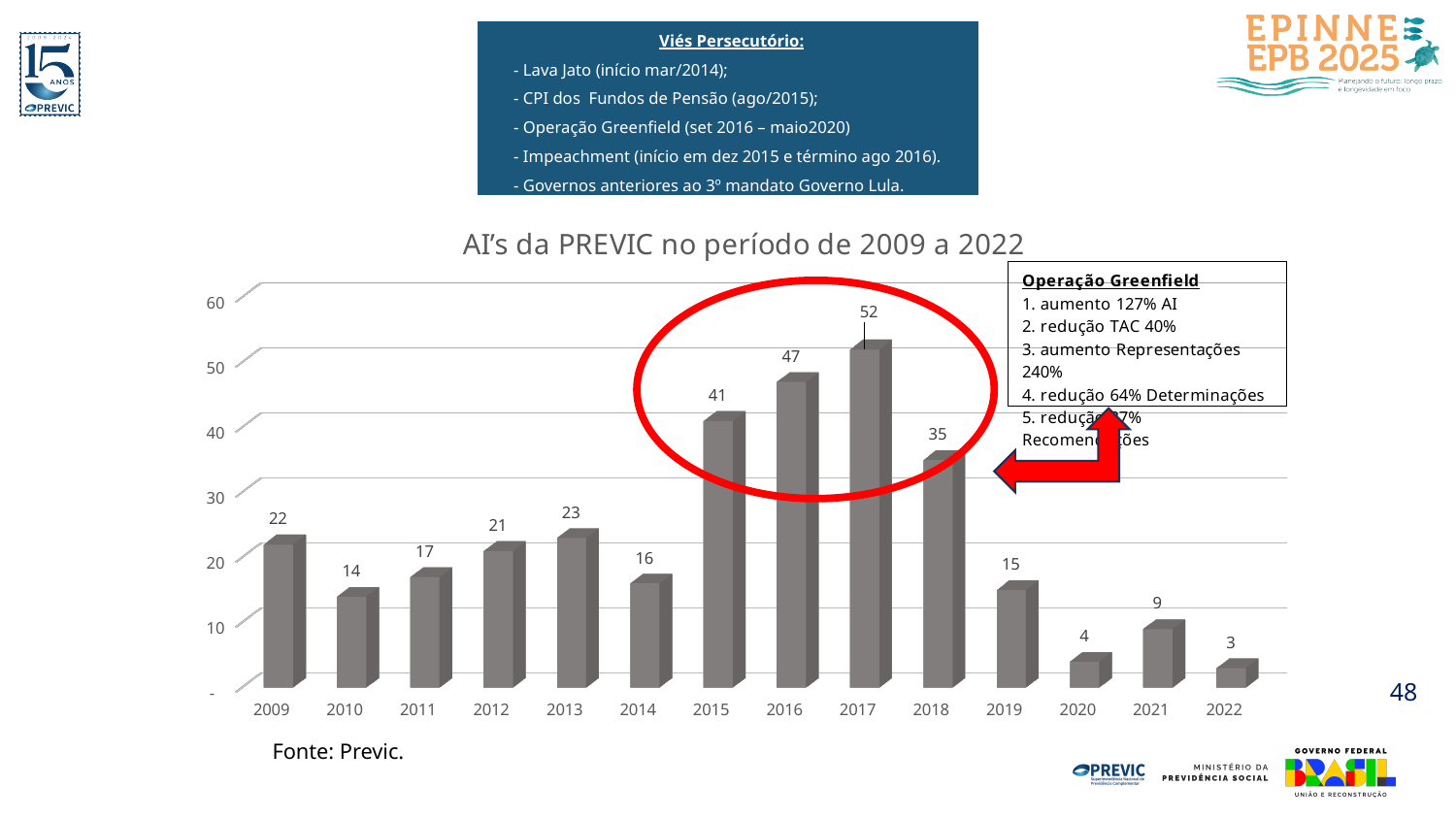
Is the value for 2016 greater or less than 40? greater What is the difference between the values for 2017 and 2016? 5 What is the title of the chart? AI’s da PREVIC no período de 2009 a 2022 What is the value for 2022? 3 What kind of chart is shown? bar chart Which year has the highest value? 2017 What is the value for 2017? 52 How many years are shown on the x axis? 14 Do the values rise or fall from 2018 to 2022? fall overall, though 2021 (9) is higher than 2020 (4) Which year has the lowest value? 2022 Which is larger, the value for 2015 or the value for 2018? 2015 What is the value for 2009? 22